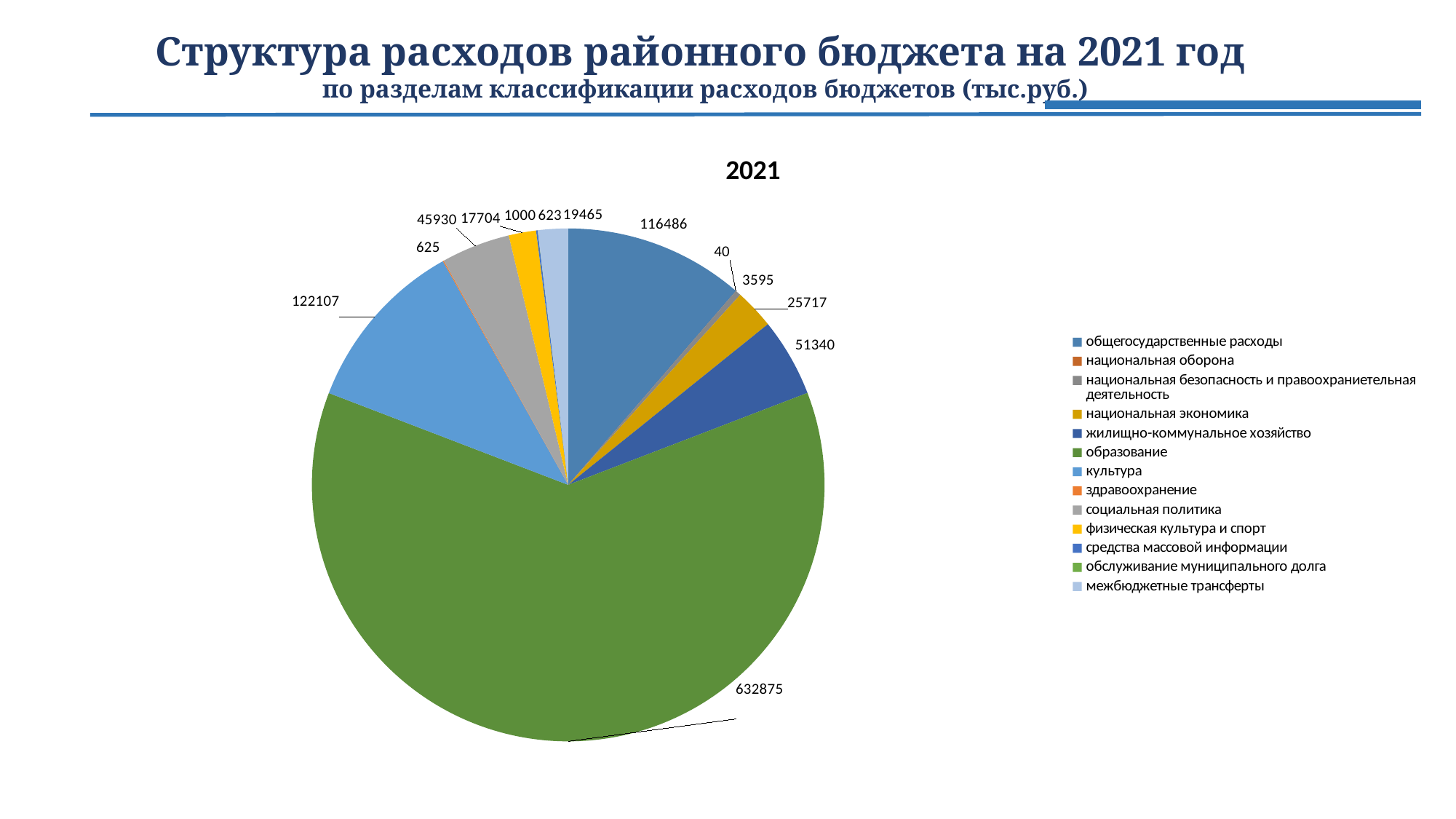
What is the value for образование in the pie chart? 632875 What is the value for общегосударственные расходы? 116486 What is the value for культура in the pie chart? 122107 What is the title shown above the pie chart? 2021 Which is larger, the value for социальная политика or the value for национальная экономика? социальная политика What kind of chart is shown on the slide? pie chart Which category has the smallest value in the pie chart? национальная оборона What is the value for жилищно-коммунальное хозяйство? 51340 Which category has the largest slice of the pie? образование How many categories does the pie chart show? 13 What is the difference between the values for культура and общегосударственные расходы? 5621 What is the value for межбюджетные трансферты? 19465